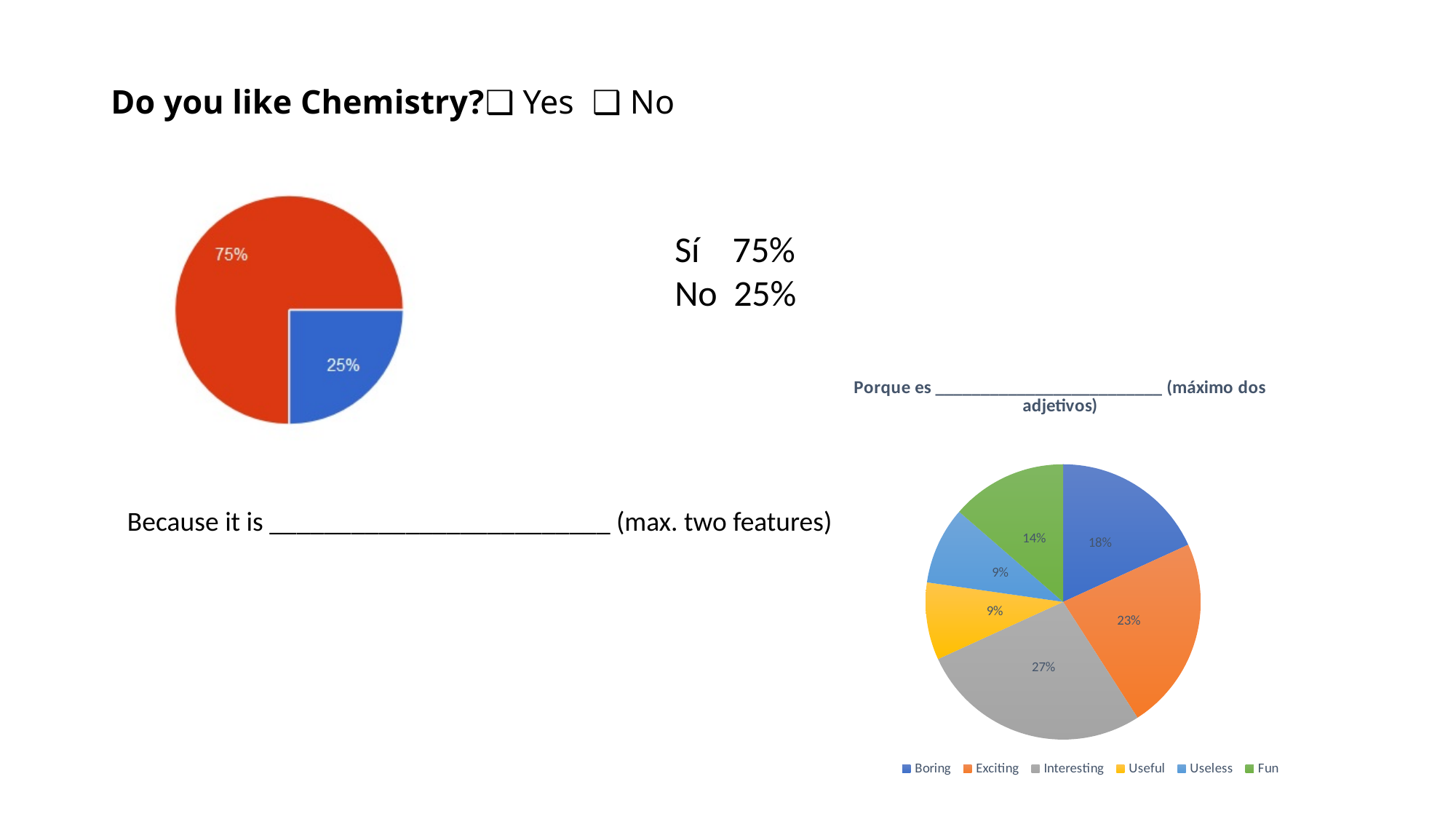
On the pie chart on the left of the slide, what share does the larger (red) slice represent? 75% On the pie chart on the left of the slide, how many slices are there? 2 On the pie chart titled 'Porque es ___ (máximo dos adjetivos)', which category has the largest share? Interesting On the pie chart titled 'Porque es ___ (máximo dos adjetivos)', what is the difference between the shares of Interesting and Useful? 18% On the pie chart on the left of the slide, what share does the smaller (blue) slice represent? 25% What kind of chart is the chart on the left of the slide? pie chart On the pie chart titled 'Porque es ___ (máximo dos adjetivos)', which colour represents Useful in the legend? yellow On the pie chart titled 'Porque es ___ (máximo dos adjetivos)', how many categories does the legend list? 6 On the pie chart titled 'Porque es ___ (máximo dos adjetivos)', what share does Boring have? 18% On the pie chart titled 'Porque es ___ (máximo dos adjetivos)', which is larger, Exciting or Boring? Exciting